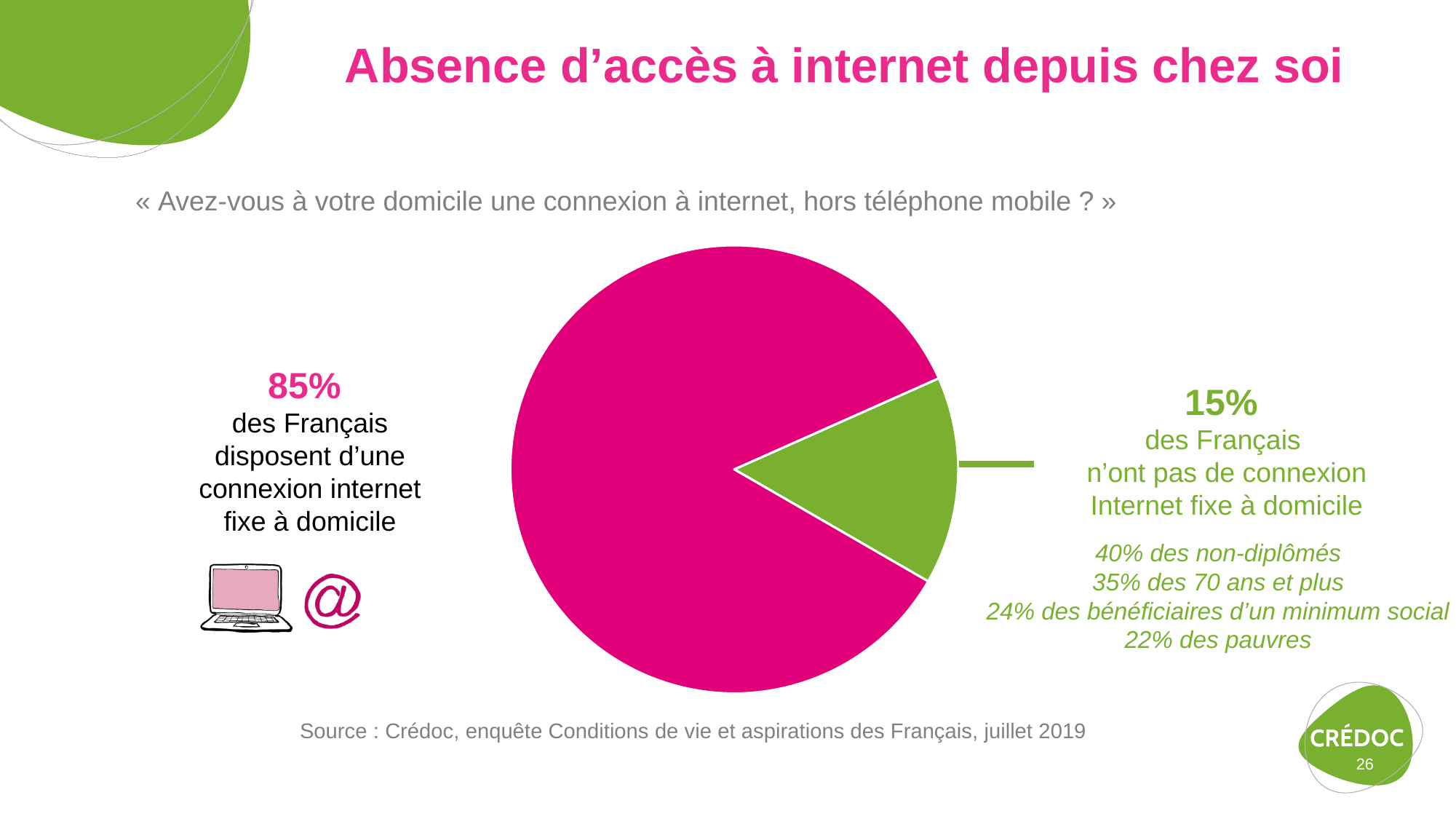
What percentage of non-graduates (non-diplômés) have no fixed home internet connection, according to the slide? 40% Which slice of the pie chart is the smallest? those without a fixed home internet connection (15%) What share of the French have a fixed internet connection at home, according to the pie chart? 85% How many slices does the pie chart have? 2 What percentage of people aged 70 and over have no fixed home internet connection, according to the slide? 35% Which slice of the pie chart is larger: those with a home internet connection or those without? those with a home internet connection (85%) Is the share of French people without a fixed home internet connection greater or less than 20%? less What kind of chart is shown on the slide? pie chart What is the difference in percentage points between the share with a home internet connection and the share without? 70 percentage points What share of the French do not have a fixed internet connection at home, according to the pie chart? 15% What colour is the slice representing the 85% of French people with a fixed home internet connection? pink What colour is the slice representing the 15% of French people without a fixed home internet connection? green